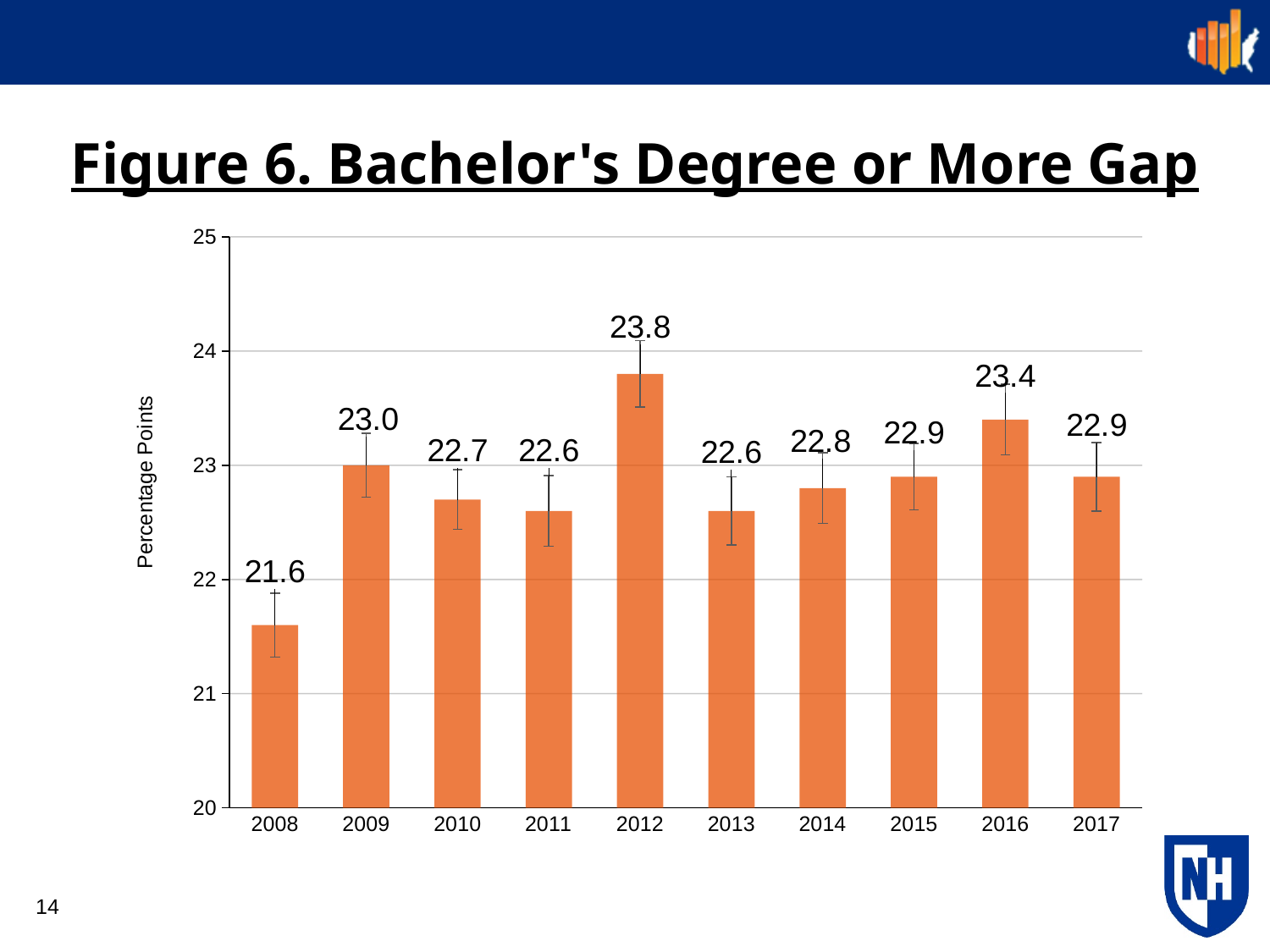
What is the value for 2016? 23.4 What kind of chart is this? bar chart Which is larger, the value for 2009 or the value for 2014? 2009 What is the difference between the values for 2012 and 2008? 2.2 What is the value for 2012? 23.8 Is the value for 2008 greater or less than 22? less Which year has the highest value? 2012 What is the value for 2008? 21.6 How many years are shown on the x axis? 10 Which year has the lowest value? 2008 What is the label of the y axis? Percentage Points What is the difference between the values for 2016 and 2017? 0.5